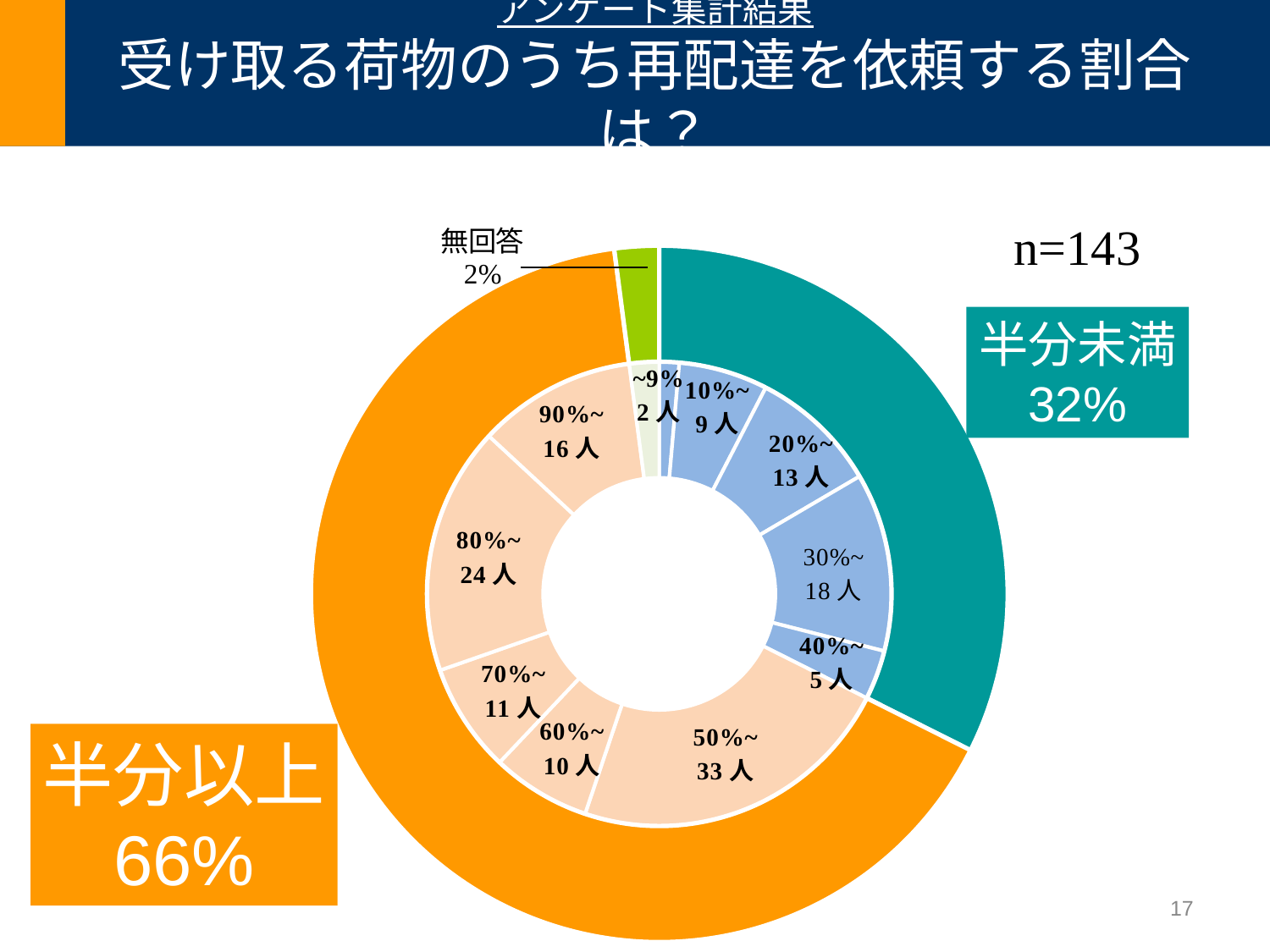
How many people are in the 80%~ segment of the inner ring? 24 人 How many people are in the 50%~ segment of the inner ring? 33 人 What share of respondents answered 半分未満 (less than half)? 32% Which segment of the inner ring has the fewest people? ~9% What share of respondents answered 半分以上 (half or more)? 66% How many people are in the 30%~ segment of the inner ring? 18 人 What kind of chart is shown on the slide? doughnut chart Which segment of the inner ring has the most people? 50%~ What is the difference in people between the 80%~ segment and the 90%~ segment? 8 人 How many segments does the inner ring of the chart have? 11 Which has more people, the 20%~ segment or the 70%~ segment? 20%~ What share of respondents gave 無回答 (no answer)? 2%